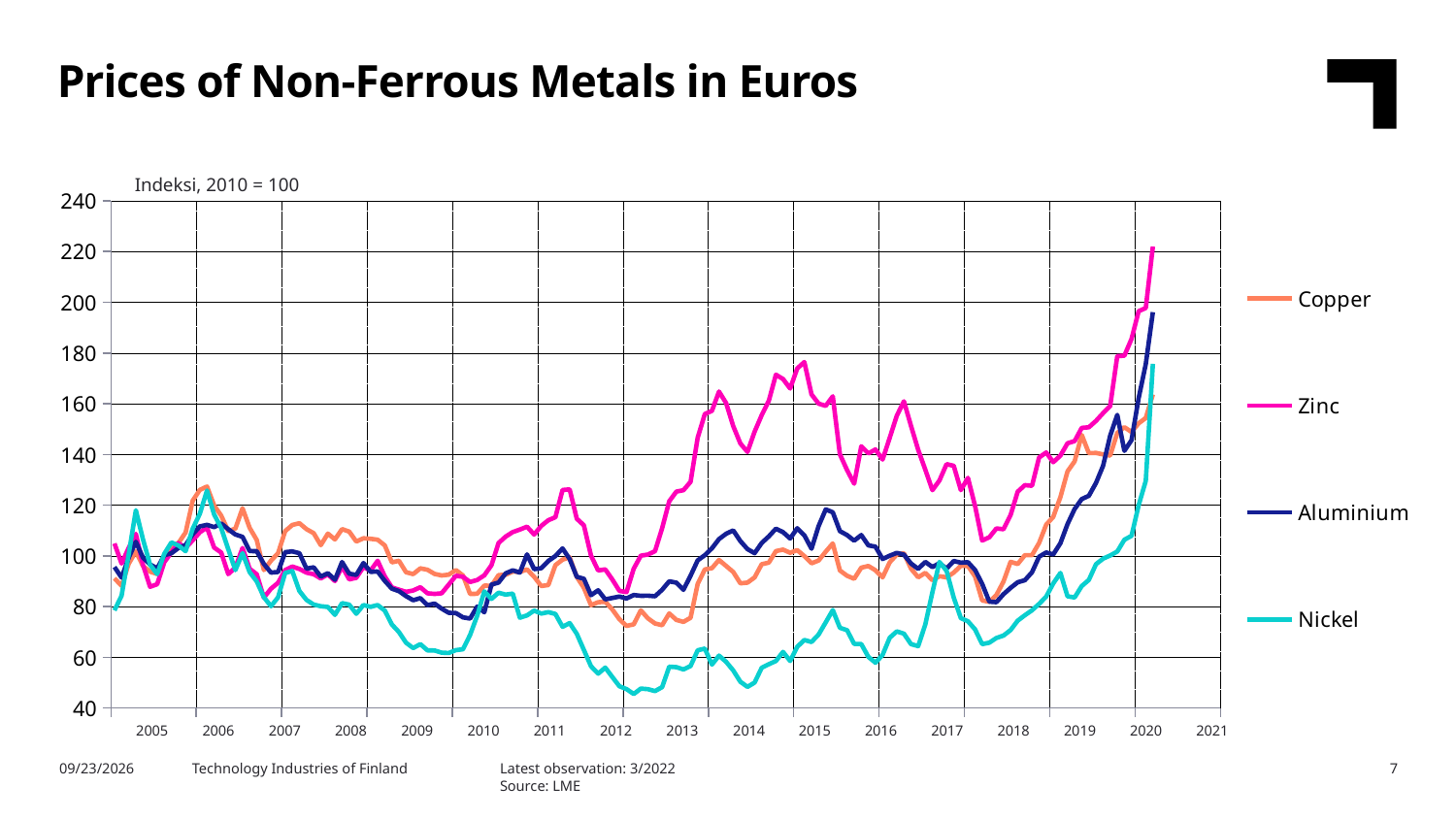
How many series does the legend list? 4 Does the Zinc series rise or fall from 2018 to the end of the chart? rise Is the lowest value for Nickel around 2012 greater or less than 60? less Is the final value for Aluminium greater or less than 180? greater Is the final value for Zinc greater or less than 200? greater What kind of chart is shown on the slide? Line chart Which series has the lowest value around 2012? Nickel Which series reaches the highest value at the right end of the chart? Zinc Which metals are listed in the legend? Copper, Zinc, Aluminium, Nickel What is the title of the chart? Prices of Non-Ferrous Metals in Euros Does the Nickel series rise or fall from 2007 to 2009? fall